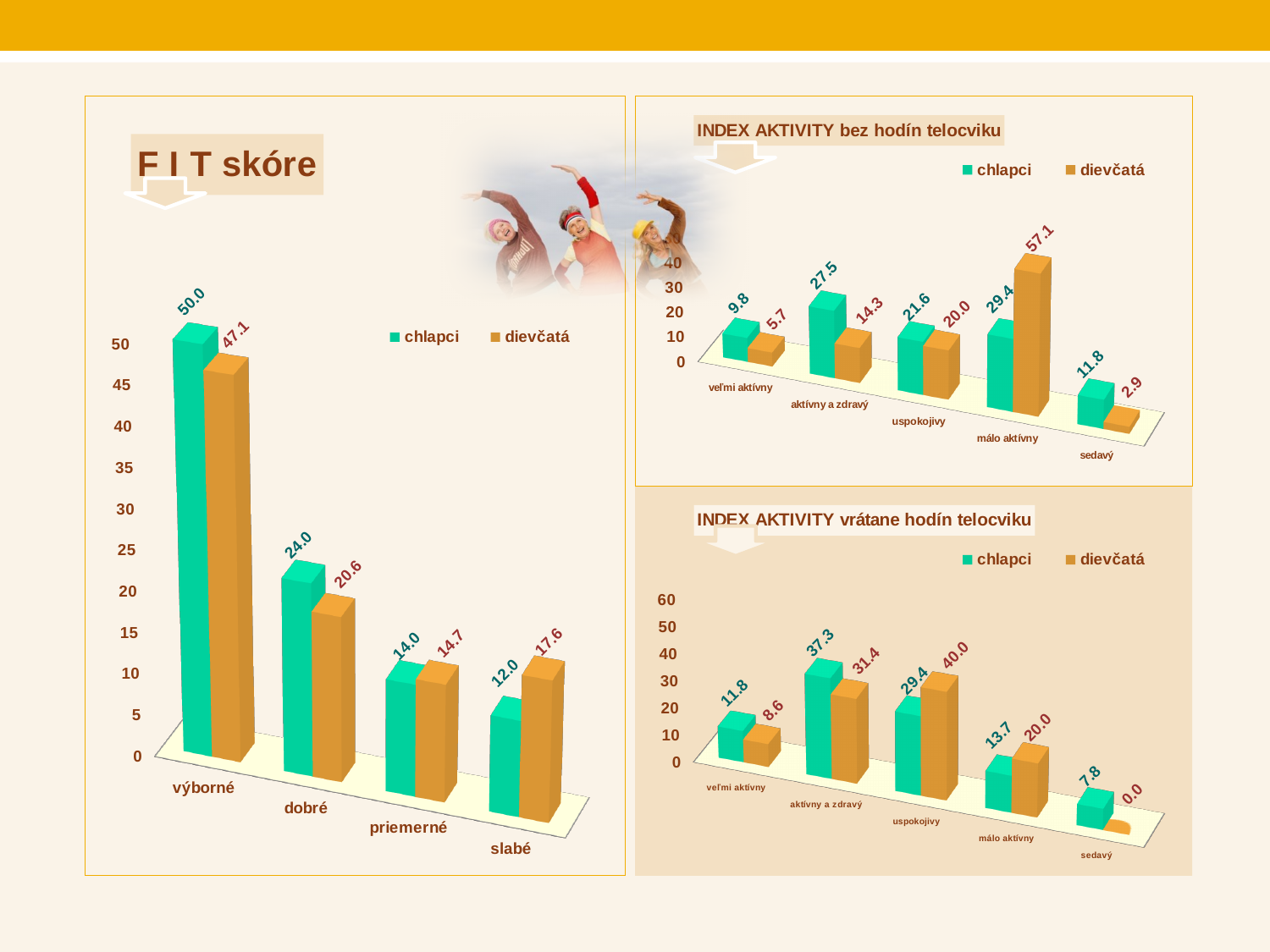
In the 'F I T skóre' chart, how many categories are shown on the x axis? 4 In the 'F I T skóre' chart, what is the difference between chlapci and dievčatá in the dobré category? 3.4 In the 'INDEX AKTIVITY bez hodín telocviku' chart, which is larger in the aktívny a zdravý category, chlapci or dievčatá? chlapci How many series does the legend of the 'INDEX AKTIVITY vrátane hodín telocviku' chart list? 2 What kind of chart is the 'F I T skóre' chart? bar chart In the 'INDEX AKTIVITY vrátane hodín telocviku' chart, what is the value for chlapci in the aktívny a zdravý category? 37.3 In the 'F I T skóre' chart, what is the value for dievčatá in the slabé category? 17.6 In the 'F I T skóre' chart, what is the value for chlapci in the výborné category? 50.0 In the 'F I T skóre' chart, which category has the highest value for chlapci? výborné In the 'INDEX AKTIVITY bez hodín telocviku' chart, what is the value for dievčatá in the málo aktívny category? 57.1 In the 'INDEX AKTIVITY bez hodín telocviku' chart, which category has the lowest value for dievčatá? sedavý In the 'INDEX AKTIVITY vrátane hodín telocviku' chart, what is the difference between dievčatá and chlapci in the uspokojivý category? 10.6